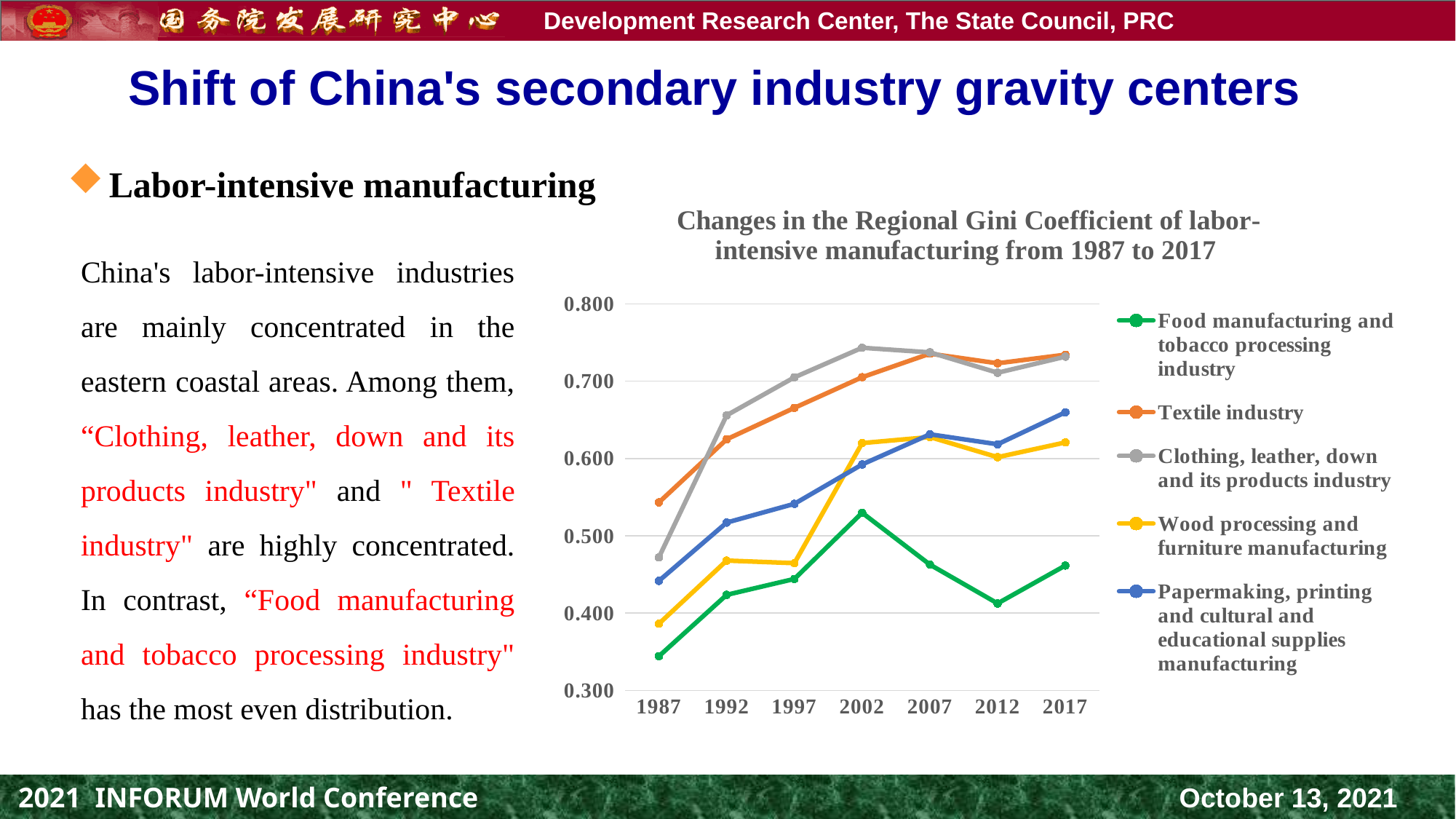
Is the value for the Textile industry in 2017 greater or less than 0.700? greater Is the value for Papermaking, printing and cultural and educational supplies manufacturing in 2017 greater or less than 0.600? greater Does the value for the Food manufacturing and tobacco processing industry rise or fall from 2007 to 2012? fall Is the value for the Food manufacturing and tobacco processing industry in 1987 greater or less than 0.400? less How many years are shown on the x axis of the chart? 7 How many series does the legend of the chart list? 5 Which series has the lowest value in 2017? Food manufacturing and tobacco processing industry What kind of chart is shown on the slide? line chart Which series has the highest value in 2002? Clothing, leather, down and its products industry In 1987, which is higher: the Textile industry or the Clothing, leather, down and its products industry? Textile industry What is the title of the chart? Changes in the Regional Gini Coefficient of labor-intensive manufacturing from 1987 to 2017